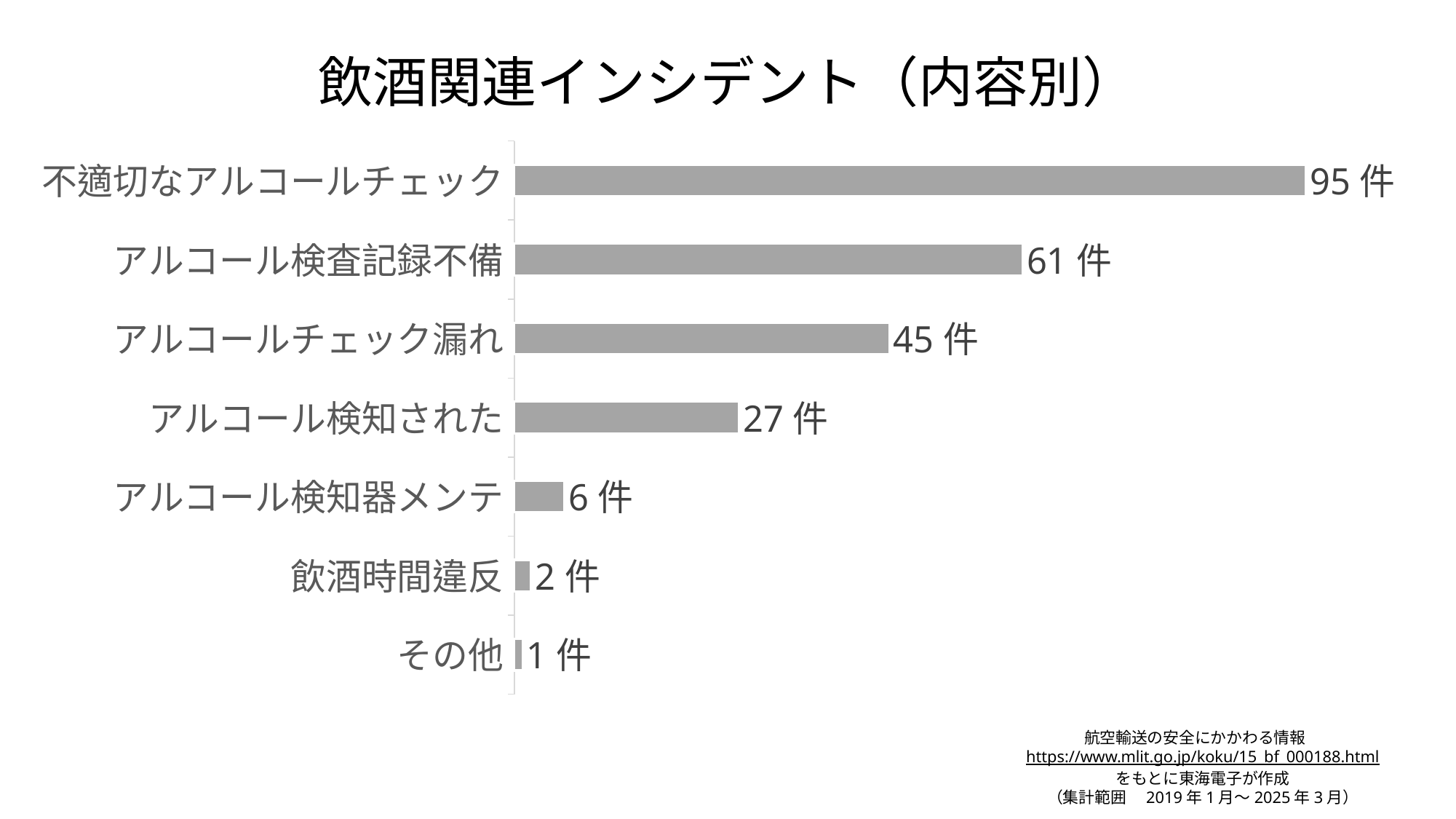
What is the value for アルコール検知された? 27 件 What kind of chart is shown on the slide? Bar chart How many categories are shown in the chart? 7 What is the difference between 不適切なアルコールチェック and アルコール検査記録不備? 34 件 What is the value for アルコール検査記録不備? 61 件 What is the value for 不適切なアルコールチェック? 95 件 Which is larger, アルコールチェック漏れ or 飲酒時間違反? アルコールチェック漏れ What is the title of the chart? 飲酒関連インシデント（内容別） What is the value for アルコール検知器メンテ? 6 件 Which category has the lowest value? その他 What is the difference between アルコールチェック漏れ and アルコール検知された? 18 件 Which category has the highest value? 不適切なアルコールチェック